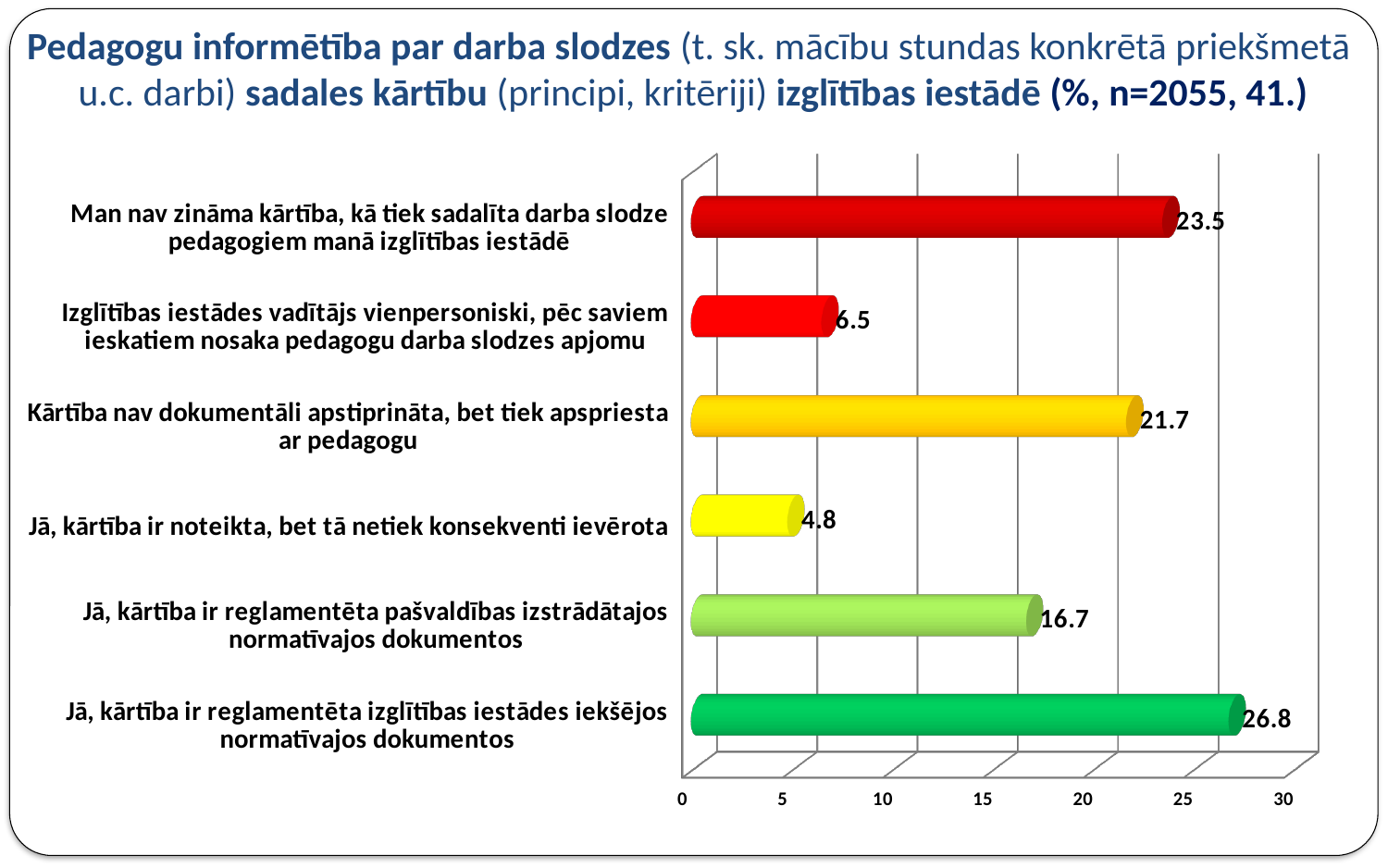
Which category has the lowest value? Jā, kārtība ir noteikta, bet tā netiek konsekventi ievērota Which category has the highest value? Jā, kārtība ir reglamentēta izglītības iestādes iekšējos normatīvajos dokumentos What is the value for "Jā, kārtība ir reglamentēta pašvaldības izstrādātajos normatīvajos dokumentos"? 16.7 Which is larger: the value for "Man nav zināma kārtība, kā tiek sadalīta darba slodze pedagogiem manā izglītības iestādē" or for "Kārtība nav dokumentāli apstiprināta, bet tiek apspriesta ar pedagogu"? Man nav zināma kārtība, kā tiek sadalīta darba slodze pedagogiem manā izglītības iestādē What is the difference between the values for "Jā, kārtība ir reglamentēta izglītības iestādes iekšējos normatīvajos dokumentos" and "Kārtība nav dokumentāli apstiprināta, bet tiek apspriesta ar pedagogu"? 5.1 Is the value for "Jā, kārtība ir reglamentēta pašvaldības izstrādātajos normatīvajos dokumentos" greater or less than 15? greater What is the sample size (n) stated in the chart title? 2055 What is the value for "Man nav zināma kārtība, kā tiek sadalīta darba slodze pedagogiem manā izglītības iestādē"? 23.5 What kind of chart is shown on the slide? bar chart How many categories are shown in the chart? 6 What is the difference between the values for "Izglītības iestādes vadītājs vienpersoniski, pēc saviem ieskatiem nosaka pedagogu darba slodzes apjomu" and "Jā, kārtība ir noteikta, bet tā netiek konsekventi ievērota"? 1.7 What is the value for "Izglītības iestādes vadītājs vienpersoniski, pēc saviem ieskatiem nosaka pedagogu darba slodzes apjomu"? 6.5